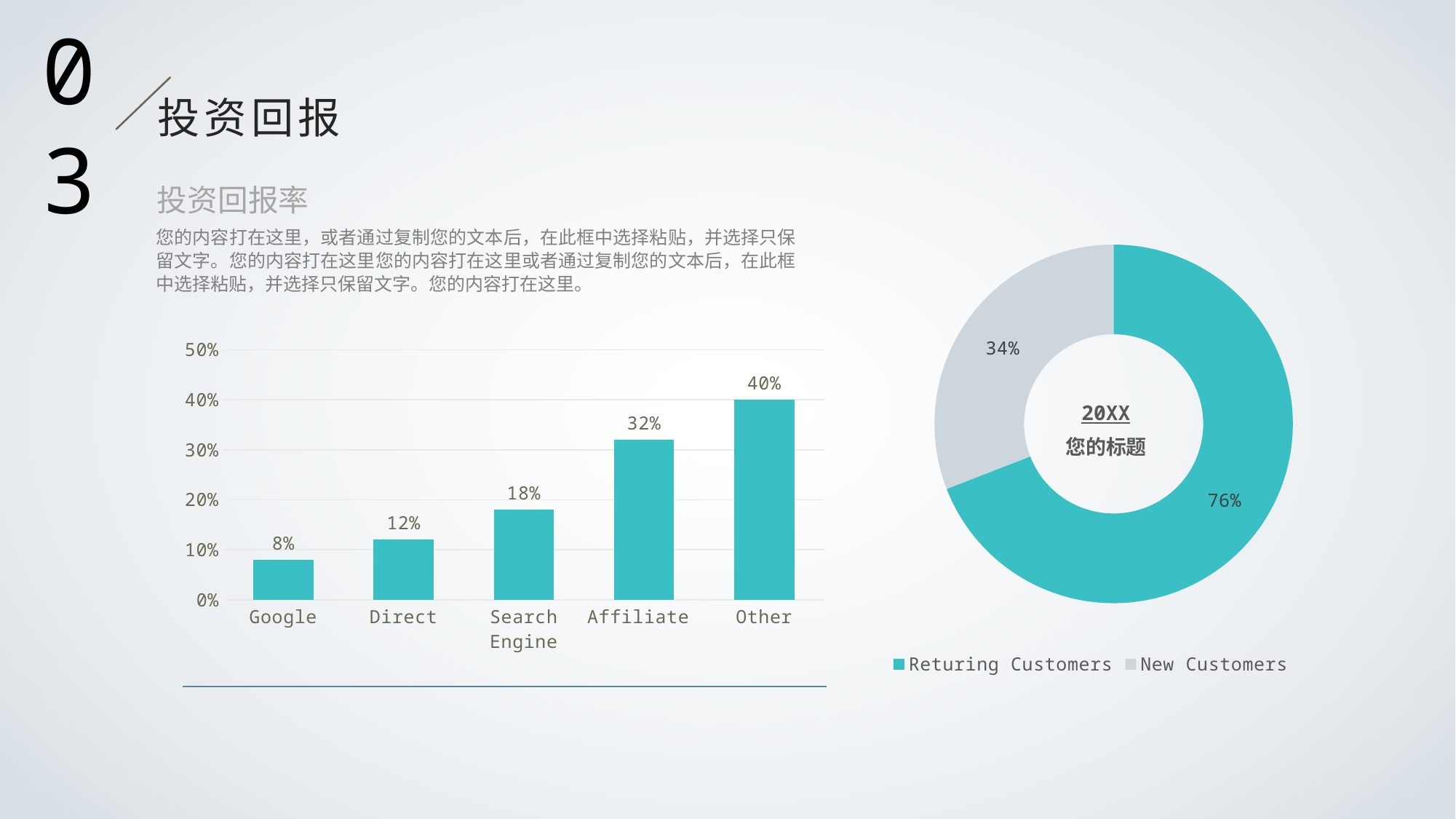
In the bar chart on the left, what is the value for Search Engine? 18% What kind of chart is shown on the left of the slide? bar chart In the bar chart on the left, which category has the lowest value? Google Do the values in the bar chart on the left rise or fall from left to right along the x axis? rise In the doughnut chart on the right, what share is labelled for New Customers? 34% In the bar chart on the left, which is larger, the value for Direct or the value for Affiliate? Affiliate How many series does the legend of the doughnut chart on the right list? 2 In the bar chart on the left, what is the difference between the values for Other and Direct? 28% How many categories are shown in the bar chart on the left? 5 In the bar chart on the left, what is the value for Affiliate? 32% In the doughnut chart on the right, what share is labelled for Returing Customers? 76% In the bar chart on the left, which category has the highest value? Other